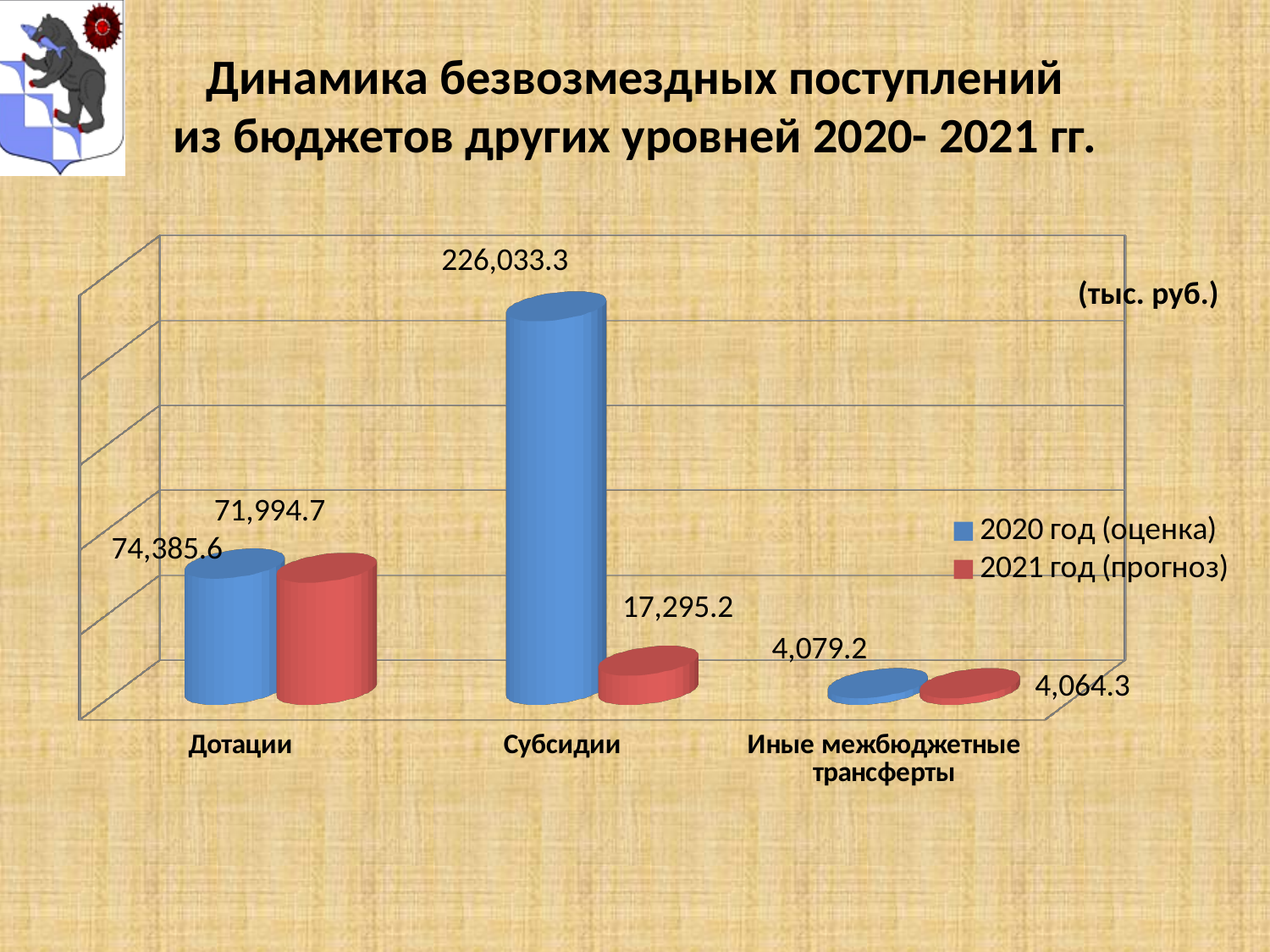
Which category has the highest value in the 2020 год (оценка) series? Субсидии What kind of chart is shown on the slide? Bar chart How many series does the legend list? 2 What is the value for Субсидии in the 2021 год (прогноз) series? 17,295.2 What is the difference between the 2020 год (оценка) and 2021 год (прогноз) values for Дотации? 2,390.9 What is the value for Дотации in the 2021 год (прогноз) series? 71,994.7 What is the difference between the 2020 год (оценка) and 2021 год (прогноз) values for Субсидии? 208,738.1 What is the value for Иные межбюджетные трансферты in the 2020 год (оценка) series? 4,079.2 How many categories are shown on the x axis? 3 Which is larger for Субсидии: the 2020 год (оценка) value or the 2021 год (прогноз) value? 2020 год (оценка) What is the value for Субсидии in the 2020 год (оценка) series? 226,033.3 Which category has the lowest value in the 2021 год (прогноз) series? Иные межбюджетные трансферты